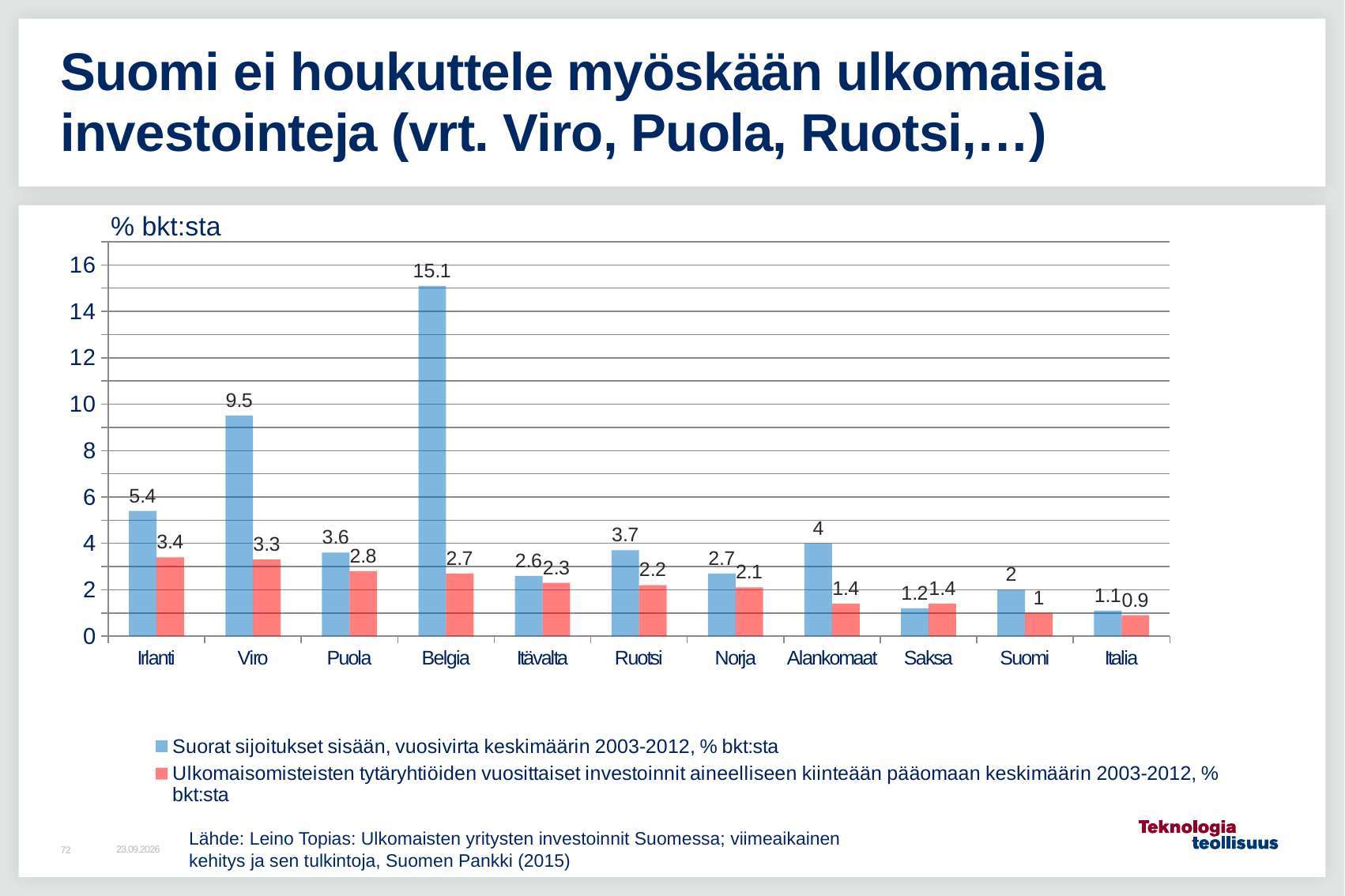
What is the value of the red series (Ulkomaisomisteisten tytäryhtiöiden vuosittaiset investoinnit) for Suomi? 1 Which country has the lowest value in the red series (Ulkomaisomisteisten tytäryhtiöiden vuosittaiset investoinnit)? Italia How many countries are shown on the x axis? 11 What unit label is shown above the y axis of the chart? % bkt:sta Is the blue series value for Alankomaat greater or less than 2? greater How many series does the legend list? 2 What kind of chart is shown on the slide? Bar chart Which is larger for Saksa: the blue series value or the red series value? The red series value (1.4) What is the difference between the blue series values for Belgia and Viro? 5.6 What is the value of the blue series (Suorat sijoitukset sisään) for Viro? 9.5 Which country has the highest value in the blue series (Suorat sijoitukset sisään)? Belgia What is the value of the blue series (Suorat sijoitukset sisään) for Belgia? 15.1